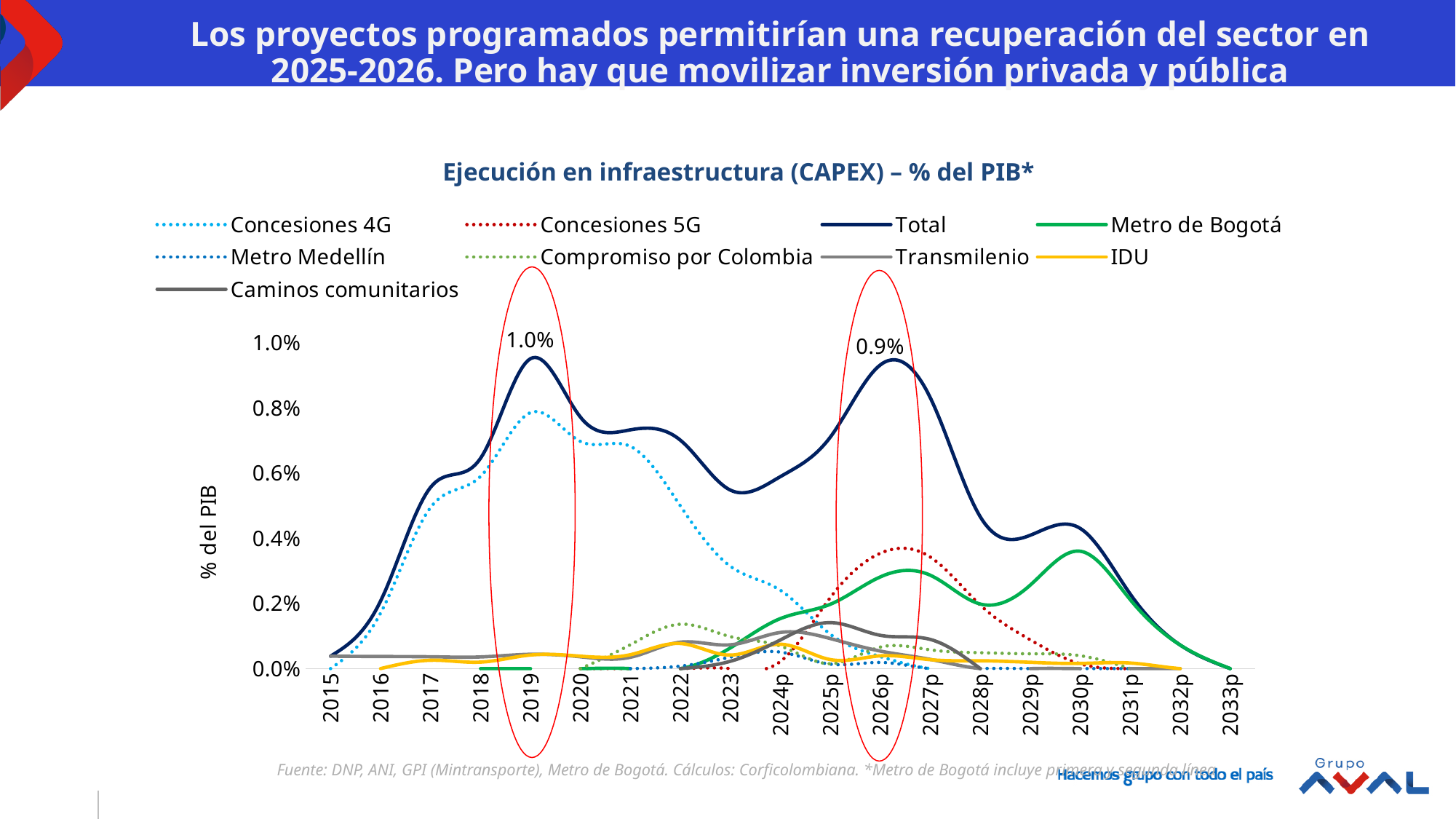
What is the difference between the labelled Total values in 2019 and 2026p? 0.1% Is the value for Concesiones 4G in 2019 greater or less than 0.6%? greater Does the Total series rise or fall from 2026p to 2028p? fall How many series does the legend list? 9 What is the labelled value of the Total series in 2019? 1.0% What is the labelled value of the Total series in 2026p? 0.9% What is the title of the chart? Ejecución en infraestructura (CAPEX) – % del PIB* Is the value for Total in 2015 greater or less than 0.2%? less What kind of chart is shown on the slide? line chart How many years are shown on the x axis? 19 Which is larger, the Total value in 2019 or in 2026p? 2019 In which year does the Total series reach its highest value? 2019